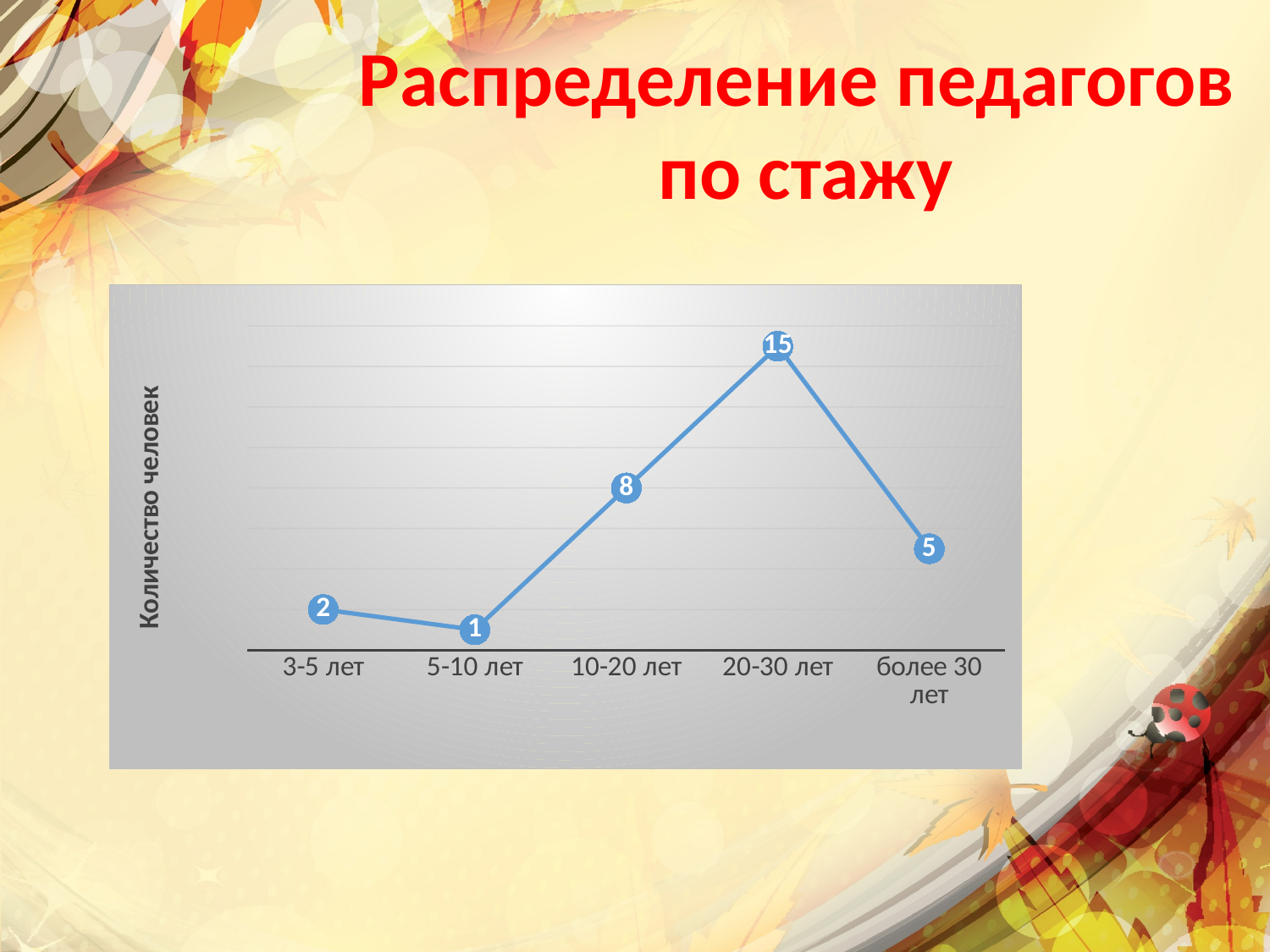
What is the label of the vertical axis? Количество человек What is the value for более 30 лет? 5 What is the value for 10-20 лет? 8 What is the value for 5-10 лет? 1 What type of chart is shown on the slide? line chart What is the value for 20-30 лет? 15 How many experience categories are shown on the x axis? 5 Which experience category has the highest number of people? 20-30 лет What is the difference between the values for 20-30 лет and 10-20 лет? 7 How many people have 3-5 лет of experience? 2 Which experience category has the lowest number of people? 5-10 лет Which is larger, the value for 3-5 лет or the value for более 30 лет? более 30 лет